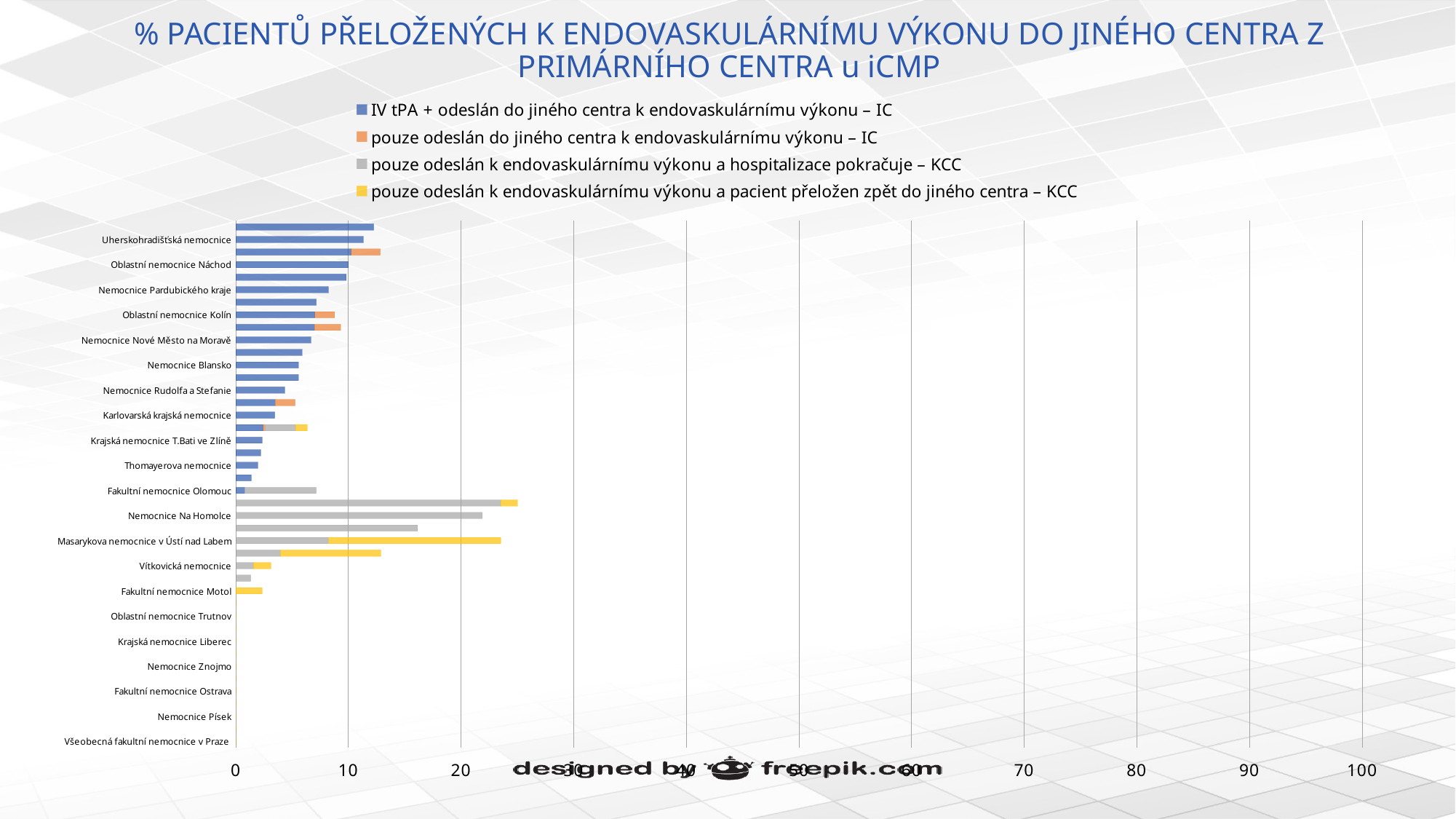
Which has the larger value, Masarykova nemocnice v Ústí nad Labem or Vítkovická nemocnice? Masarykova nemocnice v Ústí nad Labem How many series does the legend list? 4 Is the value for Nemocnice Na Homolce greater or less than 10? greater Which series is shown in yellow in the legend? pouze odeslán k endovaskulárnímu výkonu a pacient přeložen zpět do jiného centra – KCC What kind of chart is shown on the slide? bar chart Which has the larger value, Nemocnice Na Homolce or Fakultní nemocnice Motol? Nemocnice Na Homolce Is the value for Uherskohradišťská nemocnice greater or less than 20? less Is the value for Thomayerova nemocnice greater or less than 10? less Which series is shown in blue in the legend? IV tPA + odeslán do jiného centra k endovaskulárnímu výkonu – IC